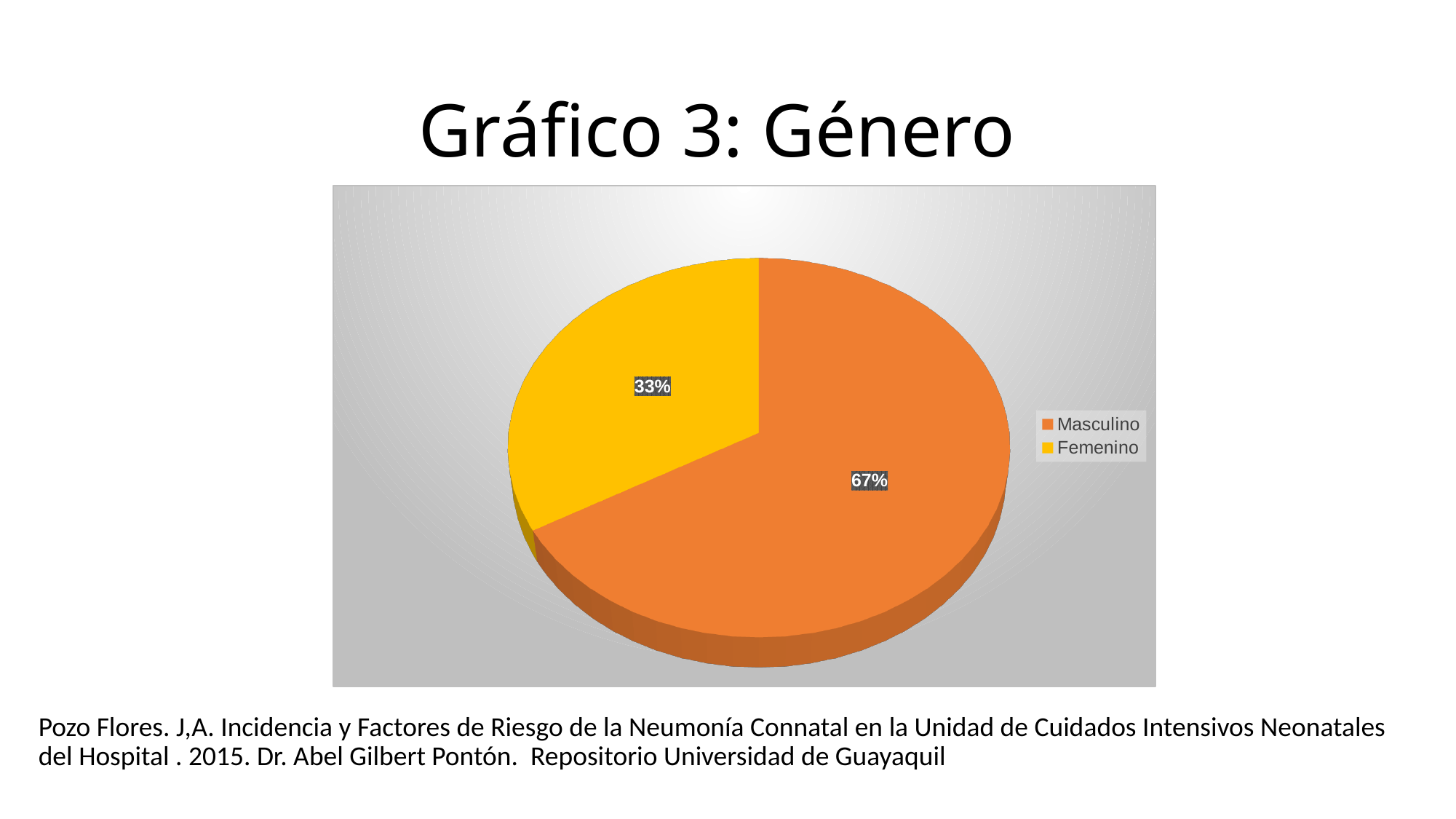
What is the title of the slide containing the chart? Gráfico 3: Género What percentage of the pie chart is Femenino? 33% Which category has the smallest share of the pie chart? Femenino How many entries does the legend list? 2 What kind of chart is shown on the slide? Pie chart What colour is the Femenino slice in the pie chart? Yellow What percentage of the pie chart is Masculino? 67% What share of the pie does the Femenino slice represent? 33% What is the difference in percentage points between the Masculino and Femenino slices? 34 Which category has the largest share of the pie chart? Masculino Which slice is larger, Masculino or Femenino? Masculino How many slices does the pie chart have? 2